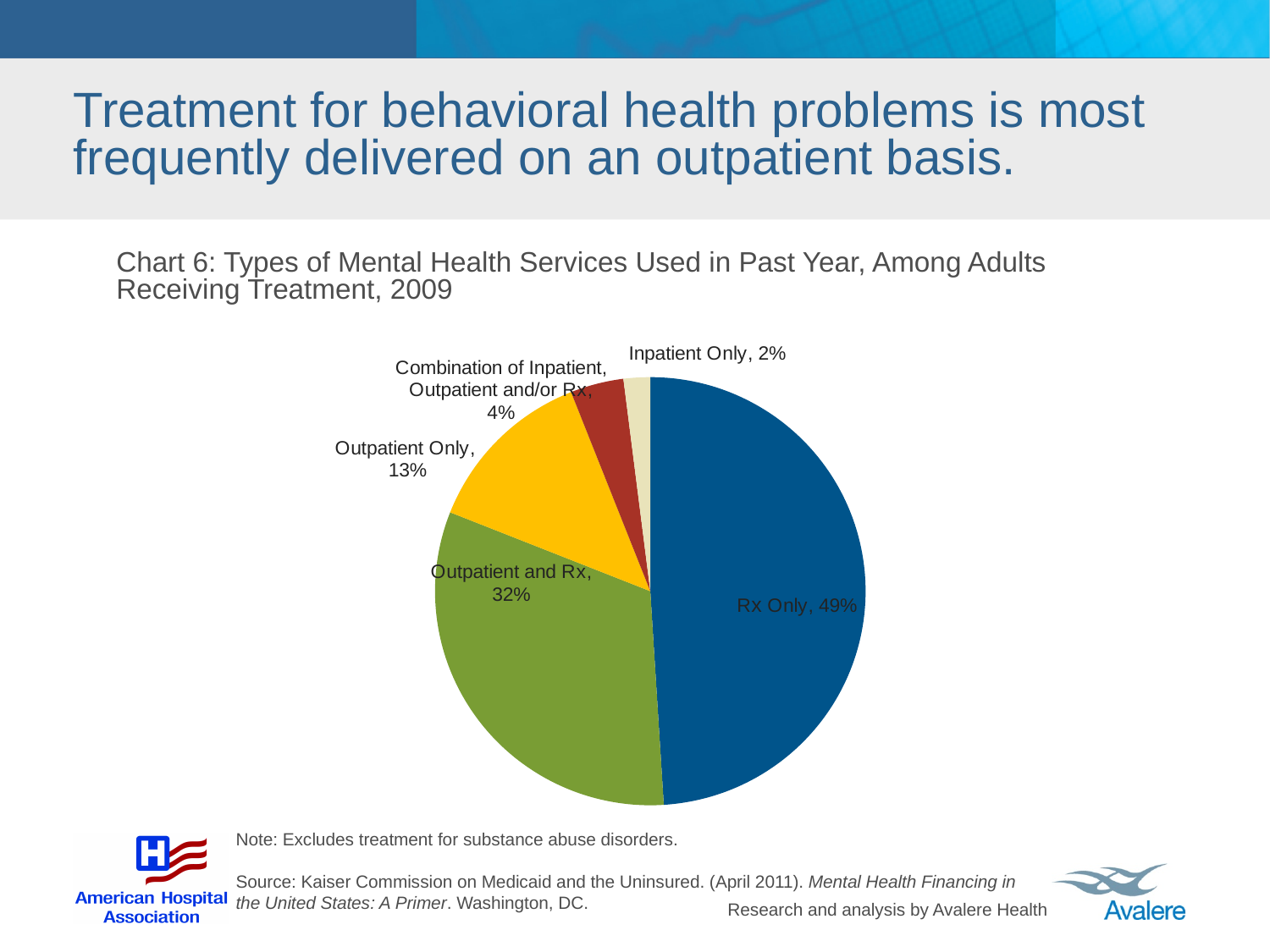
Which is larger, Outpatient Only or Combination of Inpatient, Outpatient and/or Rx? Outpatient Only What is the difference in percentage points between Rx Only and Outpatient and Rx? 17 What share of the pie is Inpatient Only? 2% What share of the pie is Outpatient Only? 13% What kind of chart is shown on the slide? Pie chart How many slices does the pie chart have? 5 What is the title of the chart? Chart 6: Types of Mental Health Services Used in Past Year, Among Adults Receiving Treatment, 2009 What share of the pie is Rx Only? 49% Which category has the largest share of the pie? Rx Only What share of the pie is Combination of Inpatient, Outpatient and/or Rx? 4% Which category has the smallest share of the pie? Inpatient Only What share of the pie is Outpatient and Rx? 32%